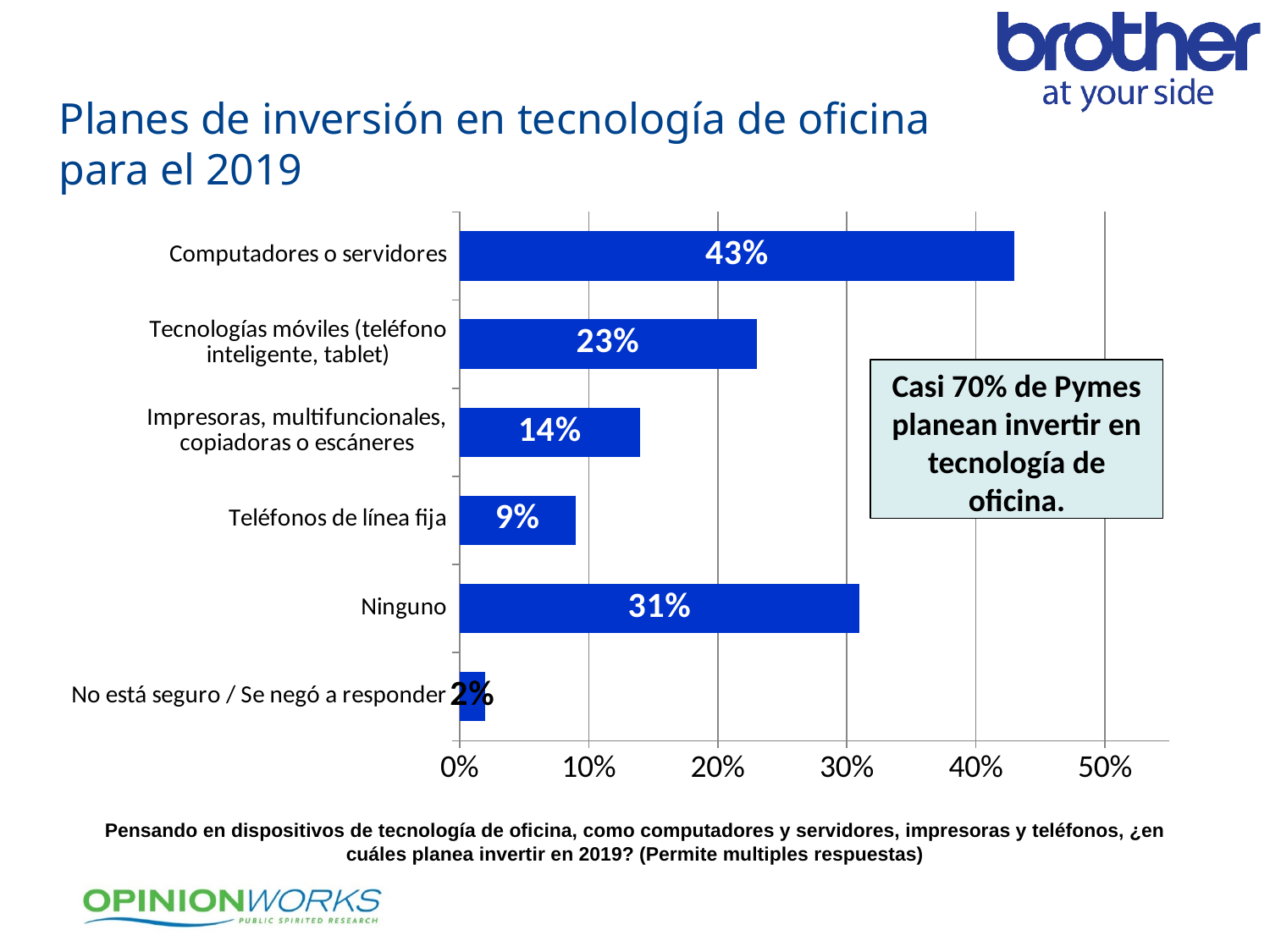
Is the value for Tecnologías móviles (teléfono inteligente, tablet) greater or less than 20%? greater What kind of chart is shown on the slide? bar chart What is the value for Tecnologías móviles (teléfono inteligente, tablet)? 23% Which category has the highest value? Computadores o servidores What is the value for Computadores o servidores? 43% What is the value for Impresoras, multifuncionales, copiadoras o escáneres? 14% What is the difference between the values for Computadores o servidores and Ninguno? 12% Which is larger, the value for Teléfonos de línea fija or the value for Impresoras, multifuncionales, copiadoras o escáneres? Impresoras, multifuncionales, copiadoras o escáneres How many categories are shown in the chart? 6 What does the text box on the chart say? Casi 70% de Pymes planean invertir en tecnología de oficina. What is the value for Ninguno? 31% Which category has the lowest value? No está seguro / Se negó a responder